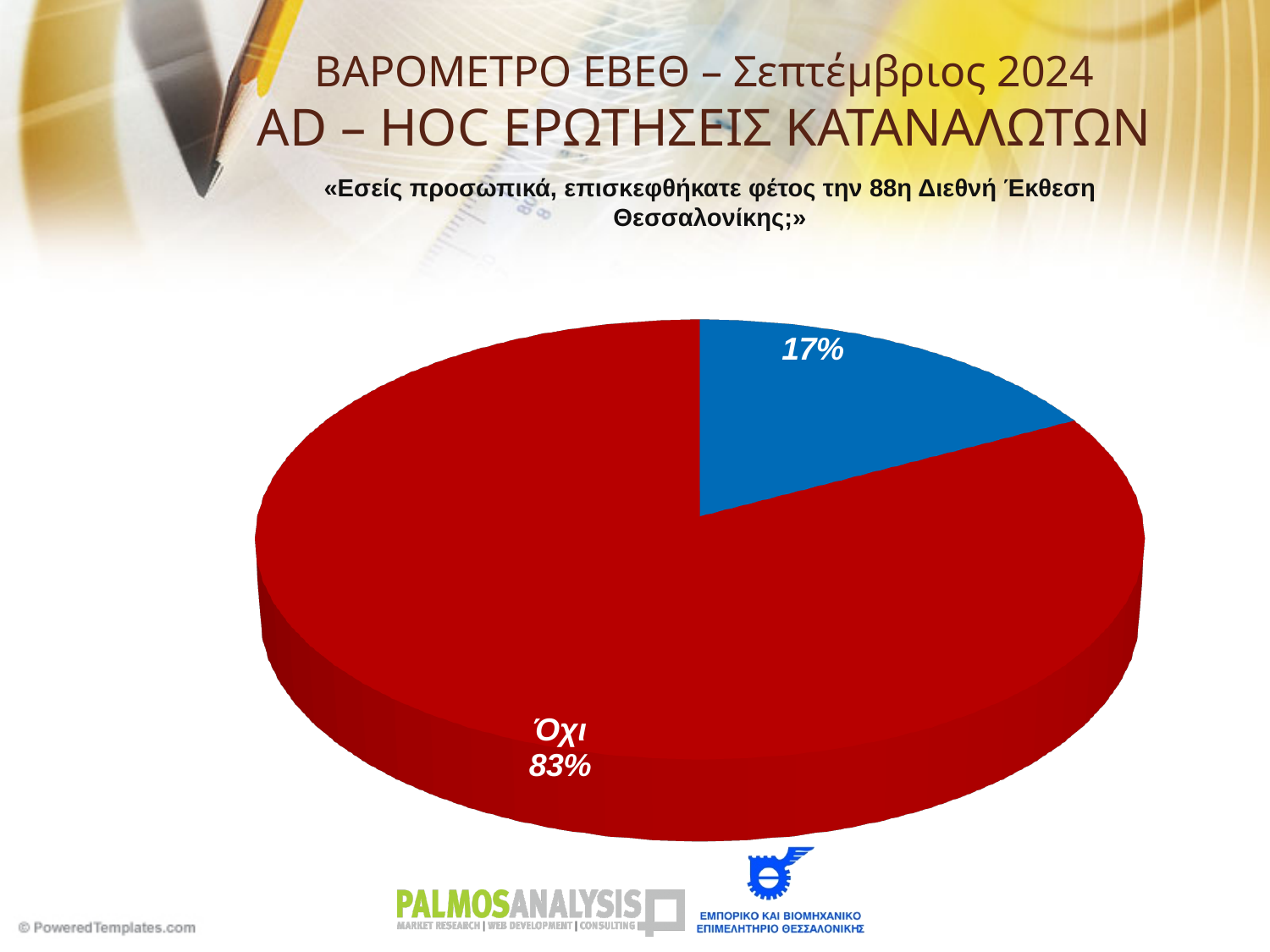
How many slices does the pie chart have? 2 Which slice of the pie is the largest? Όχι What is the difference in percentage points between the "Όχι" slice and the blue slice? 66 What colour is the "Όχι" slice of the pie? red What question is the pie chart answering, according to the text above it? «Εσείς προσωπικά, επισκεφθήκατε φέτος την 88η Διεθνή Έκθεση Θεσσαλονίκης;» What percentage is shown on the blue slice of the pie? 17% Which is larger, the "Όχι" slice or the blue slice? Όχι What kind of chart is shown on the slide? pie chart What share of the pie does the "Όχι" slice represent? 83% What is the total of the two percentages shown on the pie chart? 100%